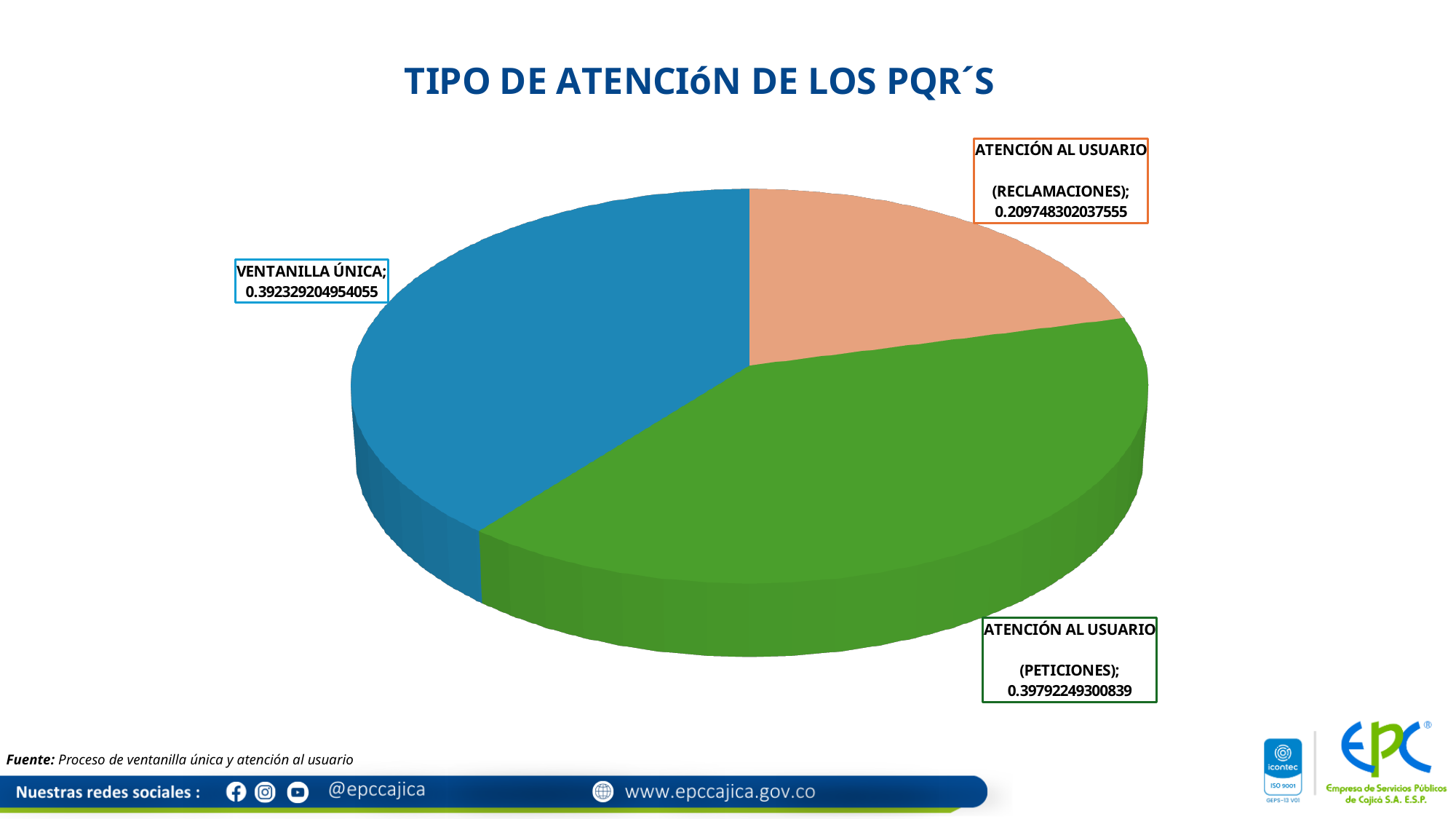
What is the value shown for VENTANILLA ÚNICA? 0.392329204954055 What share of the pie does the VENTANILLA ÚNICA slice represent? 0.392329204954055 What is the value shown for ATENCIÓN AL USUARIO (PETICIONES)? 0.39792249300839 What is the difference between the value for ATENCIÓN AL USUARIO (PETICIONES) and the value for ATENCIÓN AL USUARIO (RECLAMACIONES)? 0.188174190970835 What is the value shown for ATENCIÓN AL USUARIO (RECLAMACIONES)? 0.209748302037555 What colour is the VENTANILLA ÚNICA slice? blue Which category has the largest slice of the pie? ATENCIÓN AL USUARIO (PETICIONES) Which category has the smallest slice of the pie? ATENCIÓN AL USUARIO (RECLAMACIONES) How many slices does the pie chart have? 3 Which is larger, the value for VENTANILLA ÚNICA or the value for ATENCIÓN AL USUARIO (RECLAMACIONES)? VENTANILLA ÚNICA What is the title of the chart? TIPO DE ATENCIóN DE LOS PQR´S What kind of chart is shown on the slide? pie chart